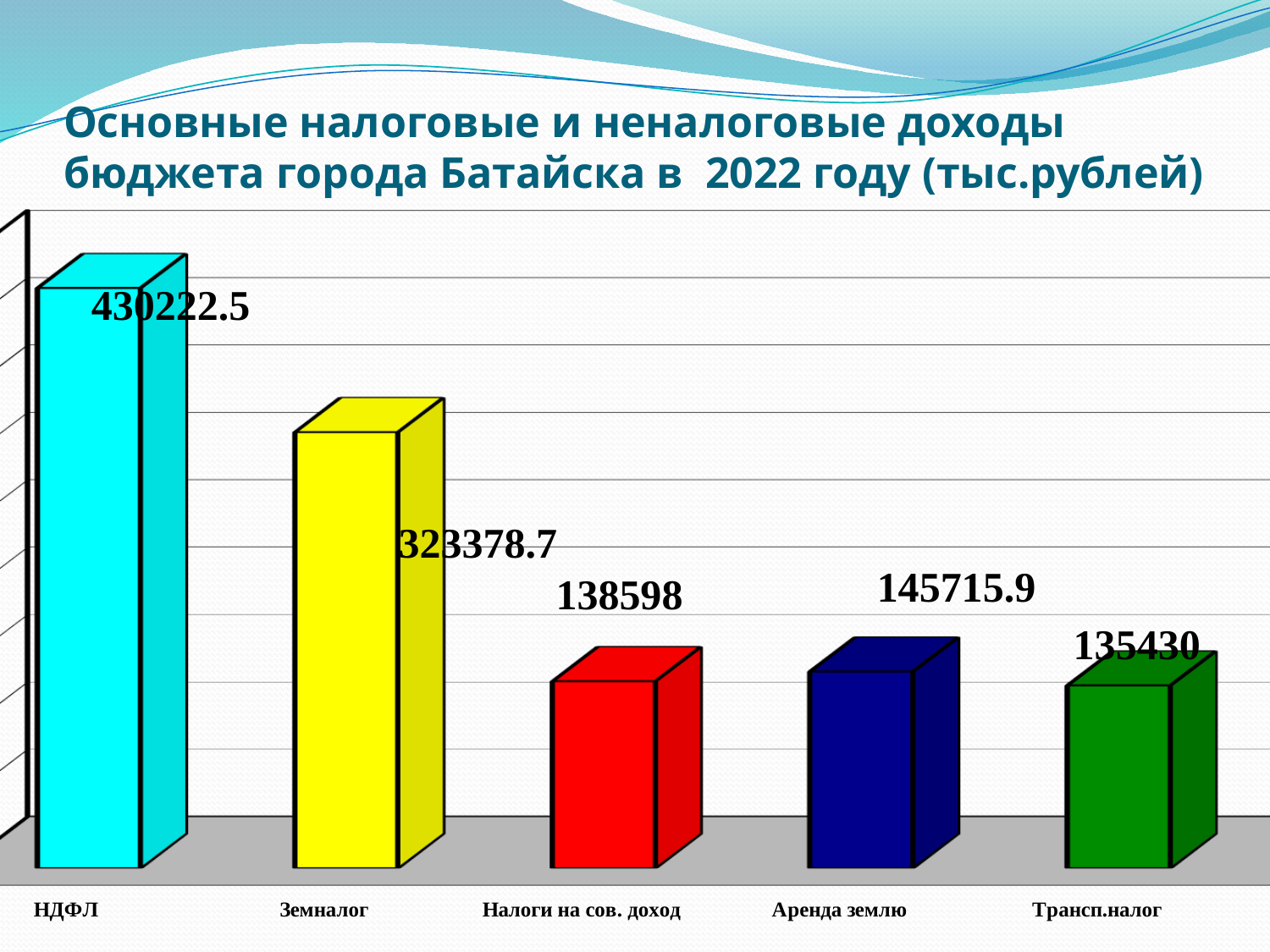
What is the difference between the values for НДФЛ and Земналог? 106843.8 What is the difference between the values for Аренда землю and Налоги на сов. доход? 7117.9 What is the value for Земналог? 323378.7 Which is larger, the value for Аренда землю or the value for Налоги на сов. доход? Аренда землю Which category has the lowest value? Трансп.налог How many categories are shown in the chart? 5 Which category has the highest value? НДФЛ What is the value for Трансп.налог? 135430 What is the value for Аренда землю? 145715.9 What colour is the bar for Налоги на сов. доход? Red What kind of chart is shown on the slide? Bar chart What is the value for НДФЛ? 430222.5